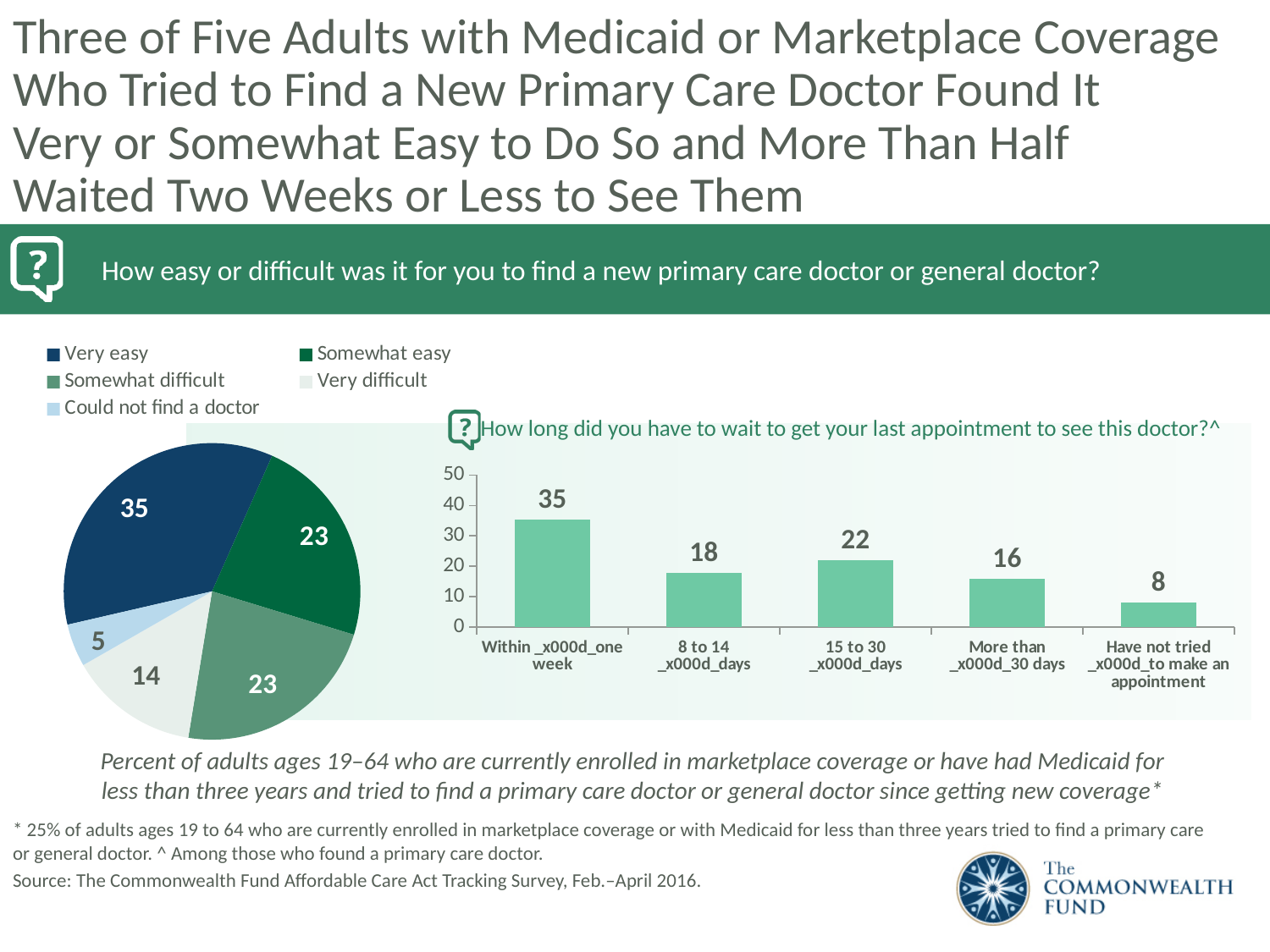
In the pie chart on the left, which response has the smallest slice? Could not find a doctor In the bar chart on the right, which category has the lowest value? Have not tried to make an appointment In the bar chart on the right, how many bars are plotted? 5 In the pie chart on the left, what percentage of adults said it was very easy to find a new primary care doctor? 35 In the bar chart on the right, what value is shown for '15 to 30 days'? 22 In the bar chart on the right, which is larger: the value for '8 to 14 days' or the value for 'More than 30 days'? 8 to 14 days In the pie chart on the left, how many categories does the legend list? 5 In the pie chart on the left, what value is shown for 'Could not find a doctor'? 5 In the bar chart on the right, what value is shown for 'Within one week'? 35 In the pie chart on the left, which response has the largest slice? Very easy What type of chart is shown on the right side of the slide? Bar chart In the pie chart on the left, what is the difference between the 'Very easy' and 'Very difficult' values? 21